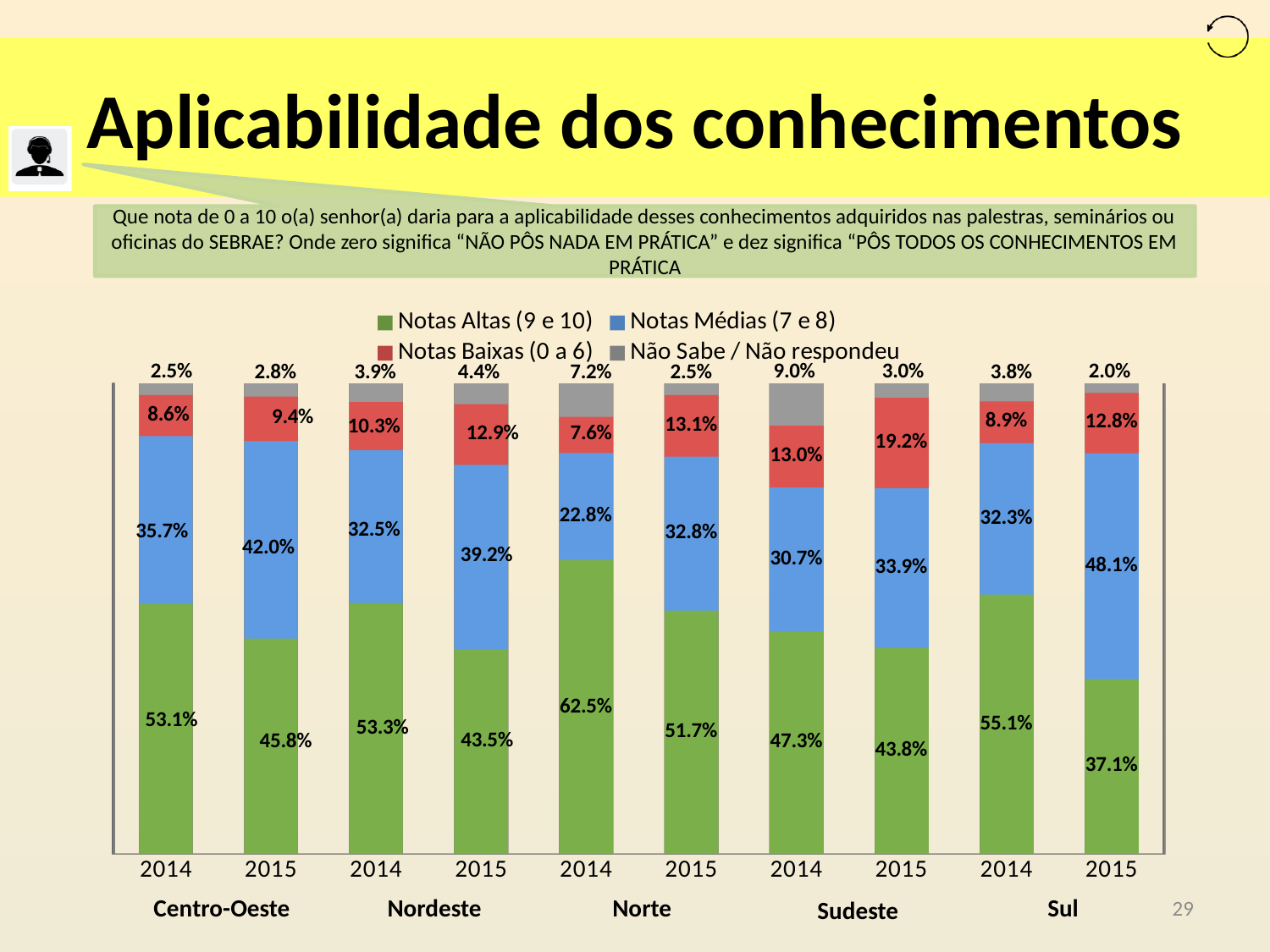
How many bars are plotted in the chart? 10 Which region and year has the highest Notas Altas (9 e 10) share? Norte 2014 Which region and year has the highest Notas Baixas (0 a 6) share? Sudeste 2015 What is the Notas Baixas (0 a 6) value for Sudeste in 2015? 19.2% Is the Notas Altas (9 e 10) share for Centro-Oeste larger in 2014 or in 2015? 2014 By how many percentage points did the Notas Altas (9 e 10) share in Norte fall from 2014 to 2015? 10.8 percentage points What is the Não Sabe / Não respondeu value for Sudeste in 2014? 9.0% What kind of chart is shown on the slide? Stacked bar chart How many series does the legend list? 4 Which region and year has the lowest Notas Altas (9 e 10) share? Sul 2015 What is the Notas Médias (7 e 8) value for Sul in 2015? 48.1% What percentage of respondents in Norte in 2014 gave Notas Altas (9 e 10)? 62.5%